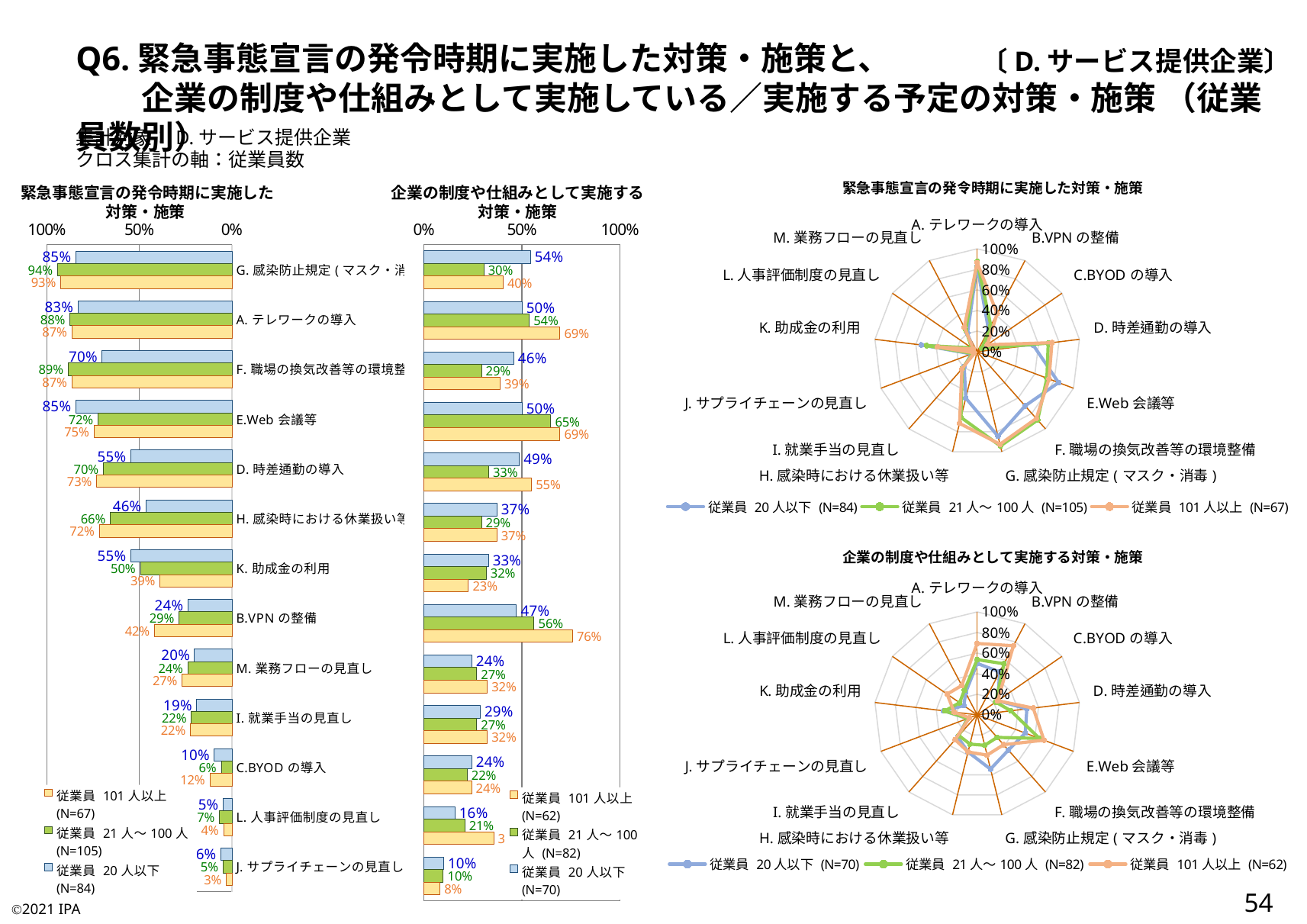
In the left bar chart (緊急事態宣言の発令時期に実施した対策・施策), for E.Web会議等, which is larger: 従業員 20人以下 or 従業員 21人～100人? 従業員 20人以下 In the left bar chart (緊急事態宣言の発令時期に実施した対策・施策), what is the value for 従業員 21人～100人 for H. 感染時における休業扱い等? 66% How many series does the legend of the left bar chart (緊急事態宣言の発令時期に実施した対策・施策) list? 3 In the left bar chart (緊急事態宣言の発令時期に実施した対策・施策), which category has the highest value for 従業員 21人～100人? G. 感染防止規定（マスク・消毒） What kind of chart is the top-right chart titled 緊急事態宣言の発令時期に実施した対策・施策? Radar chart In the left bar chart (緊急事態宣言の発令時期に実施した対策・施策), what is the difference between 従業員 21人～100人 and 従業員 20人以下 for F. 職場の換気改善等の環境整備? 19 percentage points In the left bar chart (緊急事態宣言の発令時期に実施した対策・施策), what is the value for 従業員 20人以下 for A. テレワークの導入? 83% In the middle bar chart (企業の制度や仕組みとして実施する対策・施策), what is the highest value printed for 従業員 101人以上? 76% How many categories are shown in the left bar chart (緊急事態宣言の発令時期に実施した対策・施策)? 13 In the legend of the bottom-right radar chart (企業の制度や仕組みとして実施する対策・施策), what is the N for 従業員 20人以下? N=70 In the left bar chart (緊急事態宣言の発令時期に実施した対策・施策), what is the value for 従業員 101人以上 for K. 助成金の利用? 39% In the left bar chart (緊急事態宣言の発令時期に実施した対策・施策), which category has the lowest value for 従業員 101人以上? J. サプライチェーンの見直し